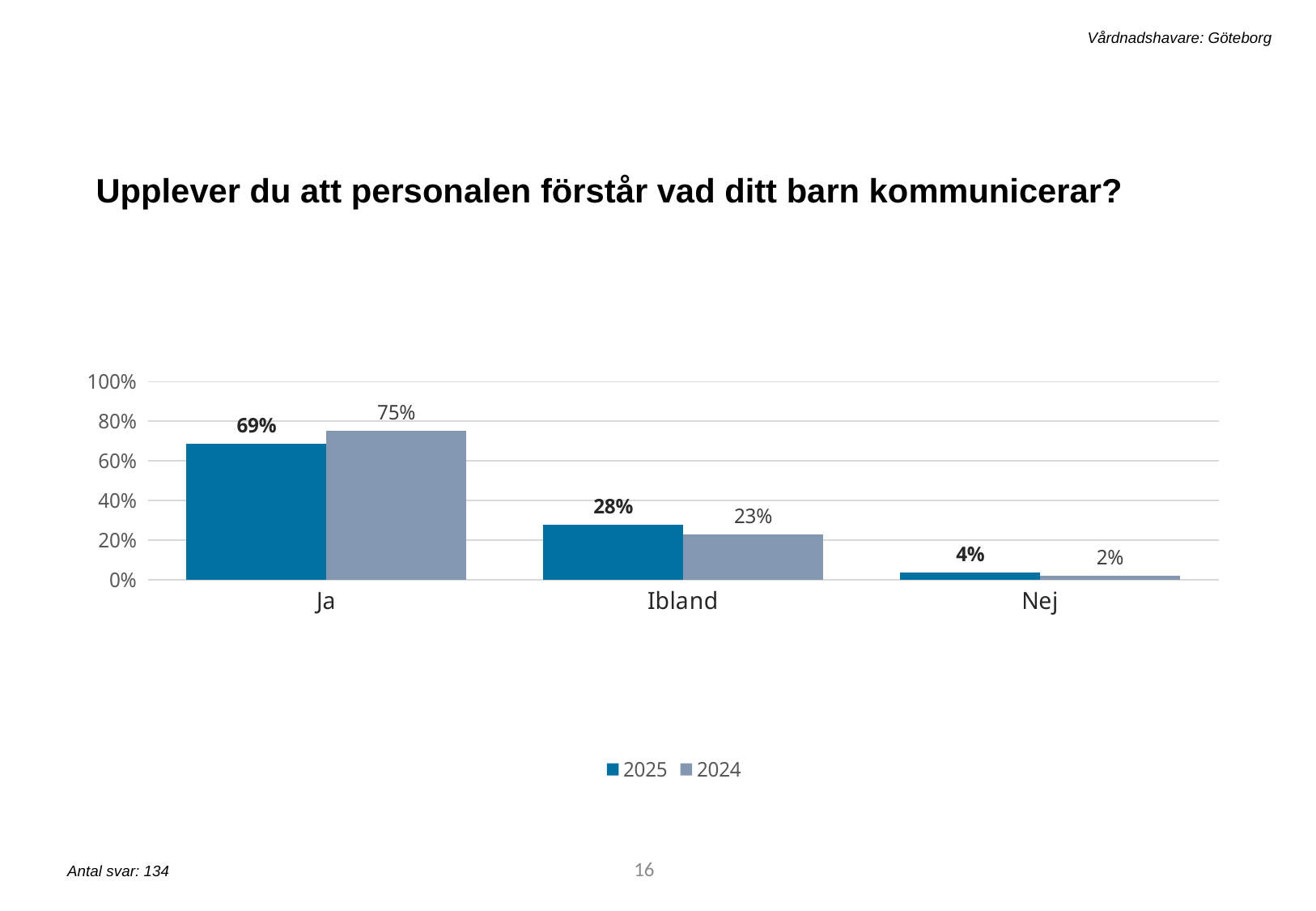
What is the title of the chart? Upplever du att personalen förstår vad ditt barn kommunicerar? Which category has the highest value in the 2024 series? Ja How many series does the legend list? 2 What is the value for "Nej" in the 2025 series? 4% How many categories are shown on the x axis? 3 What is the value for "Ja" in the 2025 series? 69% Which is larger for "Nej": the 2025 value or the 2024 value? 2025 What is the value for "Ibland" in the 2024 series? 23% What kind of chart is shown on the slide? Bar chart What is the difference between the 2024 and 2025 values for "Ja"? 6% Which category has the lowest value in the 2025 series? Nej What is the difference between the 2025 and 2024 values for "Ibland"? 5%